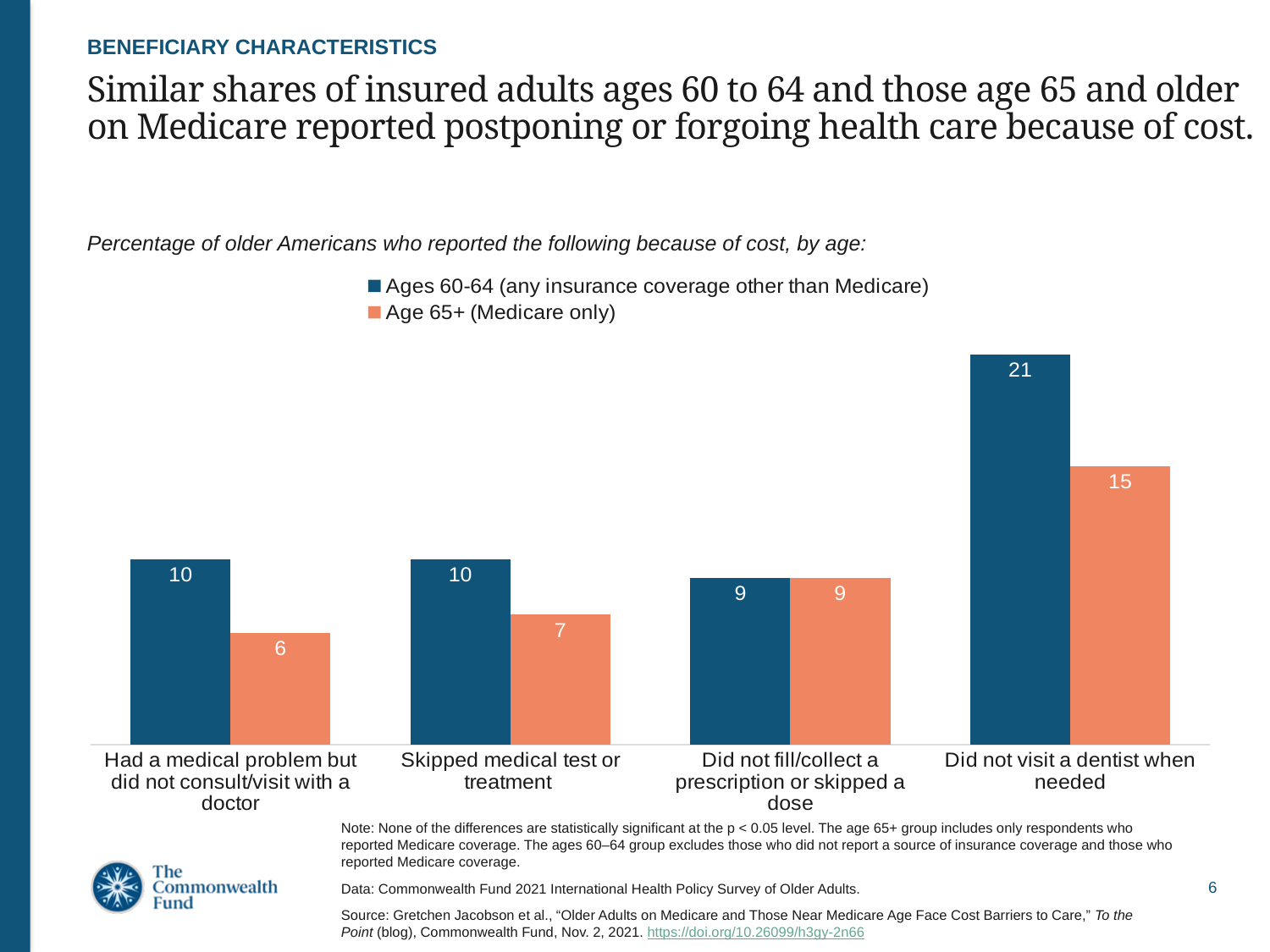
How many series does the legend list? 2 What is the difference between the Ages 60-64 and Age 65+ values for 'Did not visit a dentist when needed'? 6 What kind of chart is shown on the slide? Bar chart How many categories are shown on the x axis of the chart? 4 Which category has the lowest value for the Age 65+ (Medicare only) group? Had a medical problem but did not consult/visit with a doctor What value is shown for the Age 65+ (Medicare only) group for 'Had a medical problem but did not consult/visit with a doctor'? 6 What is the value for both groups for 'Did not fill/collect a prescription or skipped a dose'? 9 What percentage of adults age 65+ (Medicare only) reported skipping a medical test or treatment because of cost? 7 What percentage of adults ages 60-64 reported not visiting a dentist when needed because of cost? 21 Which category has the highest value for the Ages 60-64 group? Did not visit a dentist when needed Which colour represents the Age 65+ (Medicare only) series in the chart? Orange For 'Skipped medical test or treatment', which group has the larger value: Ages 60-64 or Age 65+? Ages 60-64